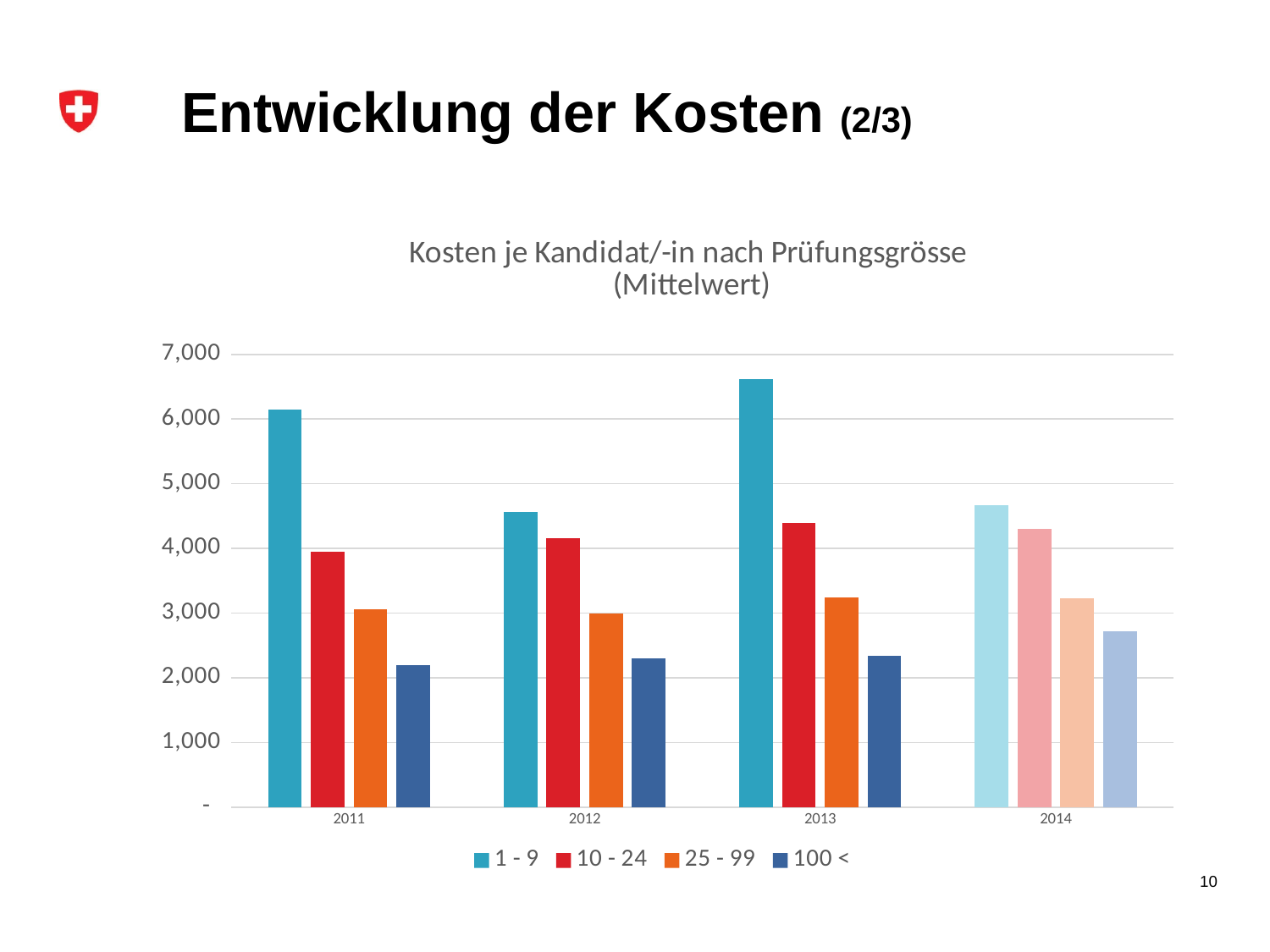
In which year is the value for the series 1 - 9 the highest? 2013 Is the value for 25 - 99 in 2011 greater or less than 4,000? less How many series does the legend list? 4 How many years are shown on the x axis? 4 What is the title of the chart? Kosten je Kandidat/-in nach Prüfungsgrösse (Mittelwert) Which series has the lowest value in every year? 100 < Is the value for 100 < in 2011 greater or less than 3,000? less Is the value for 1 - 9 in 2012 greater or less than 5,000? less What kind of chart is shown on the slide? Bar chart Do the values for the series 100 < rise or fall from 2011 to 2014? rise Which is larger, the value for 1 - 9 in 2011 or in 2012? 2011